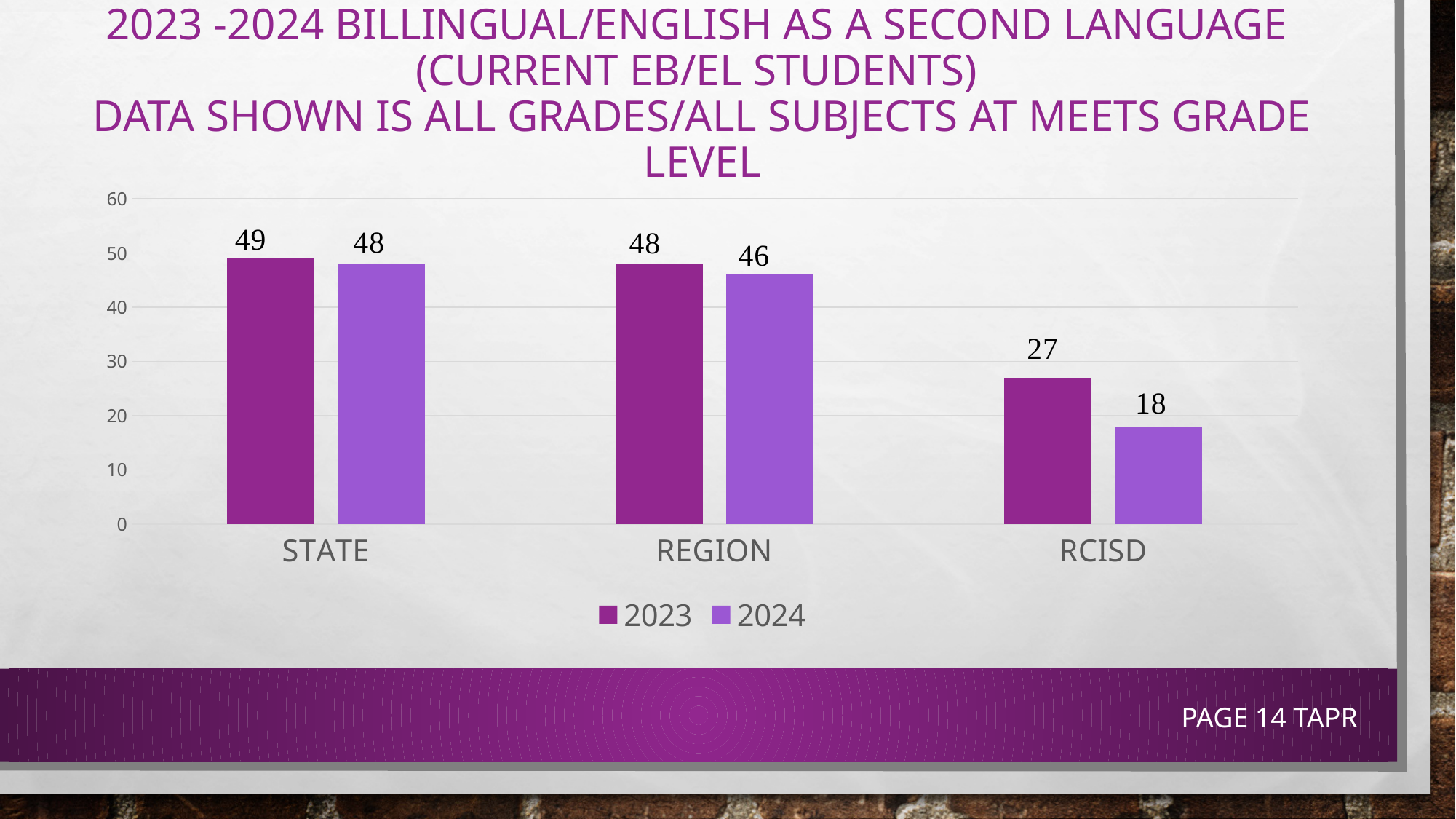
What is the difference between the 2023 and 2024 values for RCISD? 9 Which is larger, the 2024 value for STATE or the 2024 value for REGION? STATE Which category has the lowest 2024 value? RCISD What is the 2023 value for STATE? 49 What is the 2024 value for RCISD? 18 What is the difference between the 2023 values for STATE and RCISD? 22 How many series does the legend list? 2 Which category has the highest 2023 value? STATE Is the 2023 value for RCISD greater or less than 30? less What kind of chart is shown on the slide? bar chart How many categories are shown on the x axis? 3 What is the 2024 value for REGION? 46